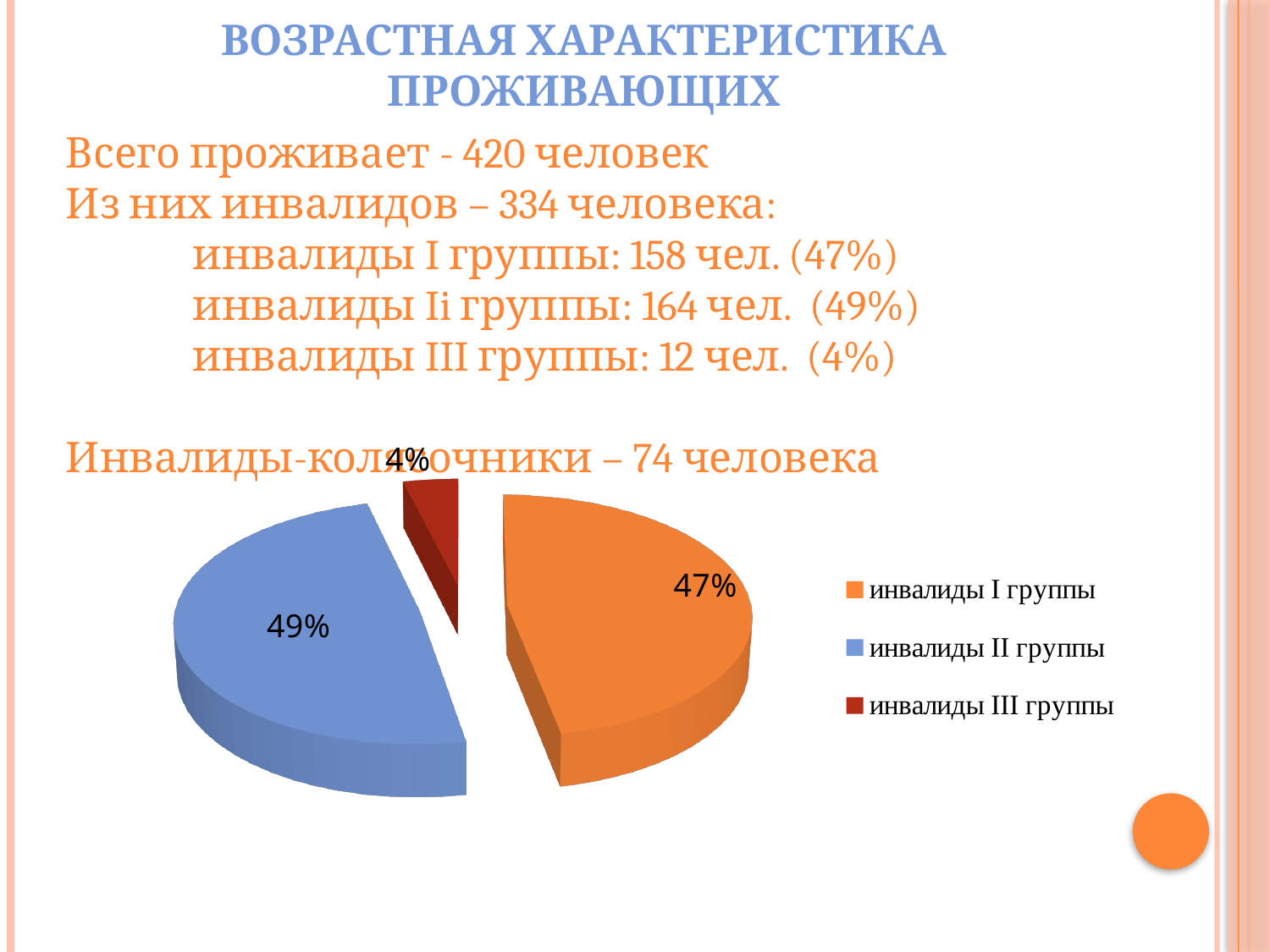
Which group has the smallest slice of the pie? инвалиды III группы What share of the pie does инвалиды I группы have? 47% How many entries does the legend list? 3 How many slices does the pie chart have? 3 What share of the pie does инвалиды II группы have? 49% What share of the pie does инвалиды III группы have? 4% Which colour represents инвалиды II группы in the pie chart? blue What is the difference in percentage points between the slices for инвалиды II группы and инвалиды I группы? 2% What kind of chart is shown on the slide? pie chart Which group has the largest slice of the pie? инвалиды II группы What is the difference in percentage points between the slices for инвалиды I группы and инвалиды III группы? 43% Which colour represents инвалиды III группы in the pie chart? dark red